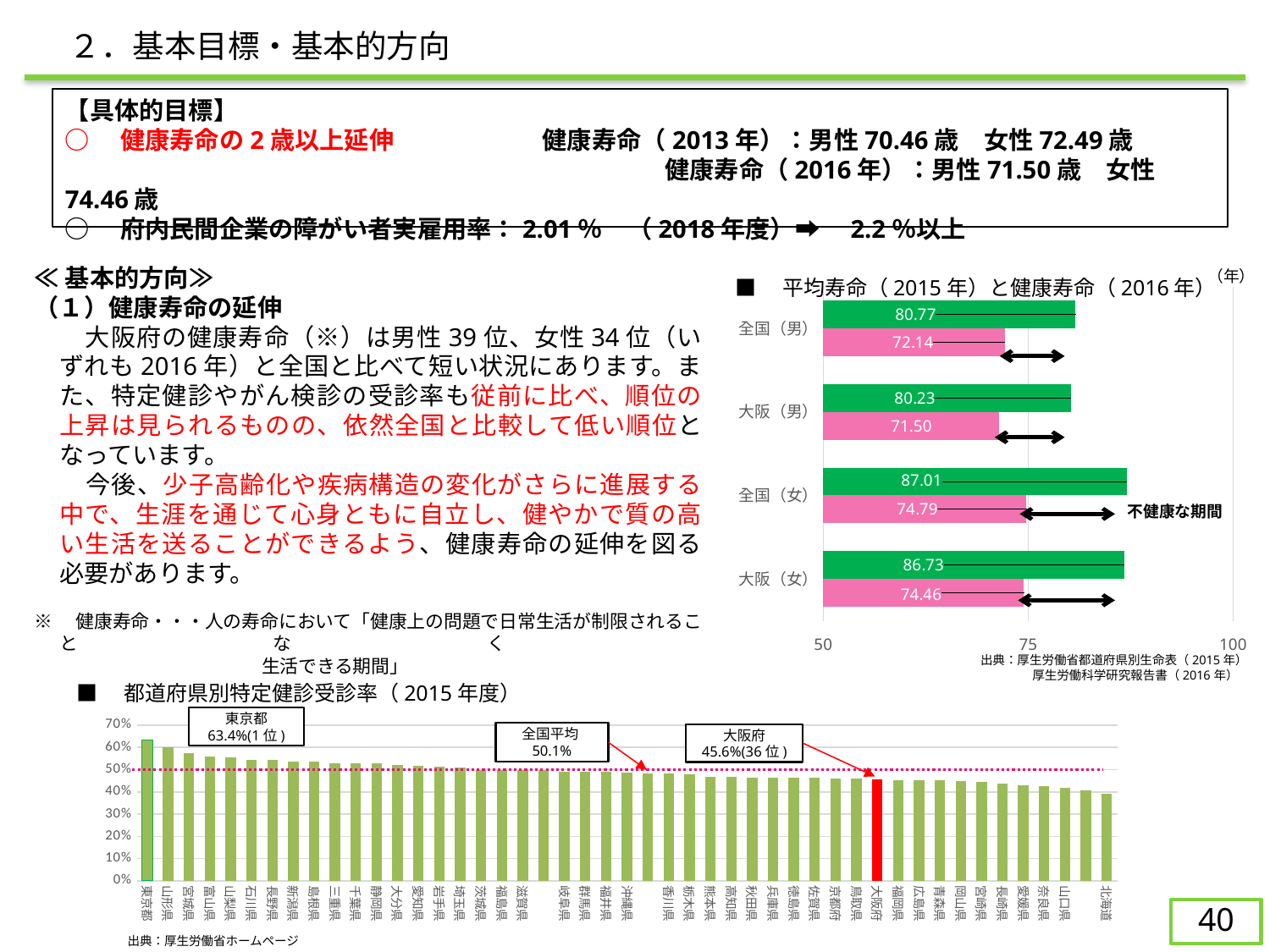
In the chart titled 平均寿命（2015年）と健康寿命（2016年）, is the 健康寿命 value for 大阪（男）greater or less than 75? less In the chart titled 都道府県別特定健診受診率（2015年度）, what is the 全国平均 value shown? 50.1% In the chart titled 平均寿命（2015年）と健康寿命（2016年）, what is the 健康寿命 value for 大阪（男）? 71.50 In the chart titled 平均寿命（2015年）と健康寿命（2016年）, what is the 健康寿命 value for 全国（女）? 74.79 In the chart titled 平均寿命（2015年）と健康寿命（2016年）, what is the 平均寿命 value for 全国（男）? 80.77 In the chart titled 平均寿命（2015年）と健康寿命（2016年）, which category has the highest 平均寿命 value? 全国（女） In the chart titled 平均寿命（2015年）と健康寿命（2016年）, what is the difference between the 平均寿命 and 健康寿命 values for 大阪（女）? 12.27 In the chart titled 都道府県別特定健診受診率（2015年度）, what is the value for 大阪府? 45.6% In the chart titled 平均寿命（2015年）と健康寿命（2016年）, how many categories are shown on the vertical axis? 4 In the chart titled 都道府県別特定健診受診率（2015年度）, what kind of chart is it? bar chart In the chart titled 都道府県別特定健診受診率（2015年度）, what is the value for 東京都? 63.4% In the chart titled 都道府県別特定健診受診率（2015年度）, do the values rise or fall from left to right along the x axis? fall